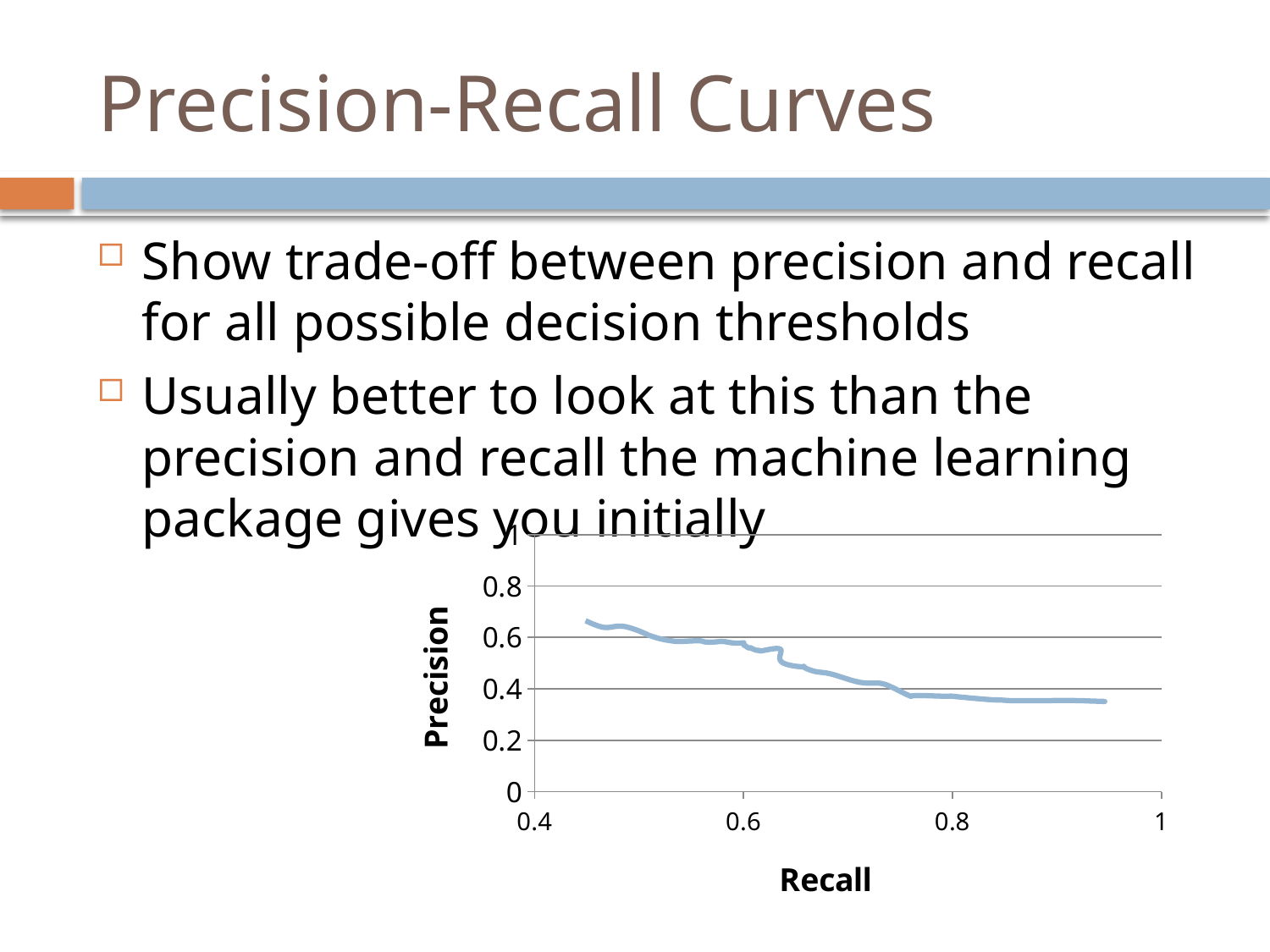
Is the precision at a recall of 0.5 greater or less than 0.4? greater What is the lowest value shown on the x axis? 0.4 What is the label of the x axis? Recall Is the precision at the left end of the curve (recall about 0.45) greater or less than 0.6? greater What is the label of the y axis? Precision Is the precision at a recall of 0.9 greater or less than 0.2? greater What kind of chart is shown on the slide? line chart Is precision higher at a recall of 0.5 or at a recall of 0.9? 0.5 Does precision rise or fall as recall increases along the x axis? fall